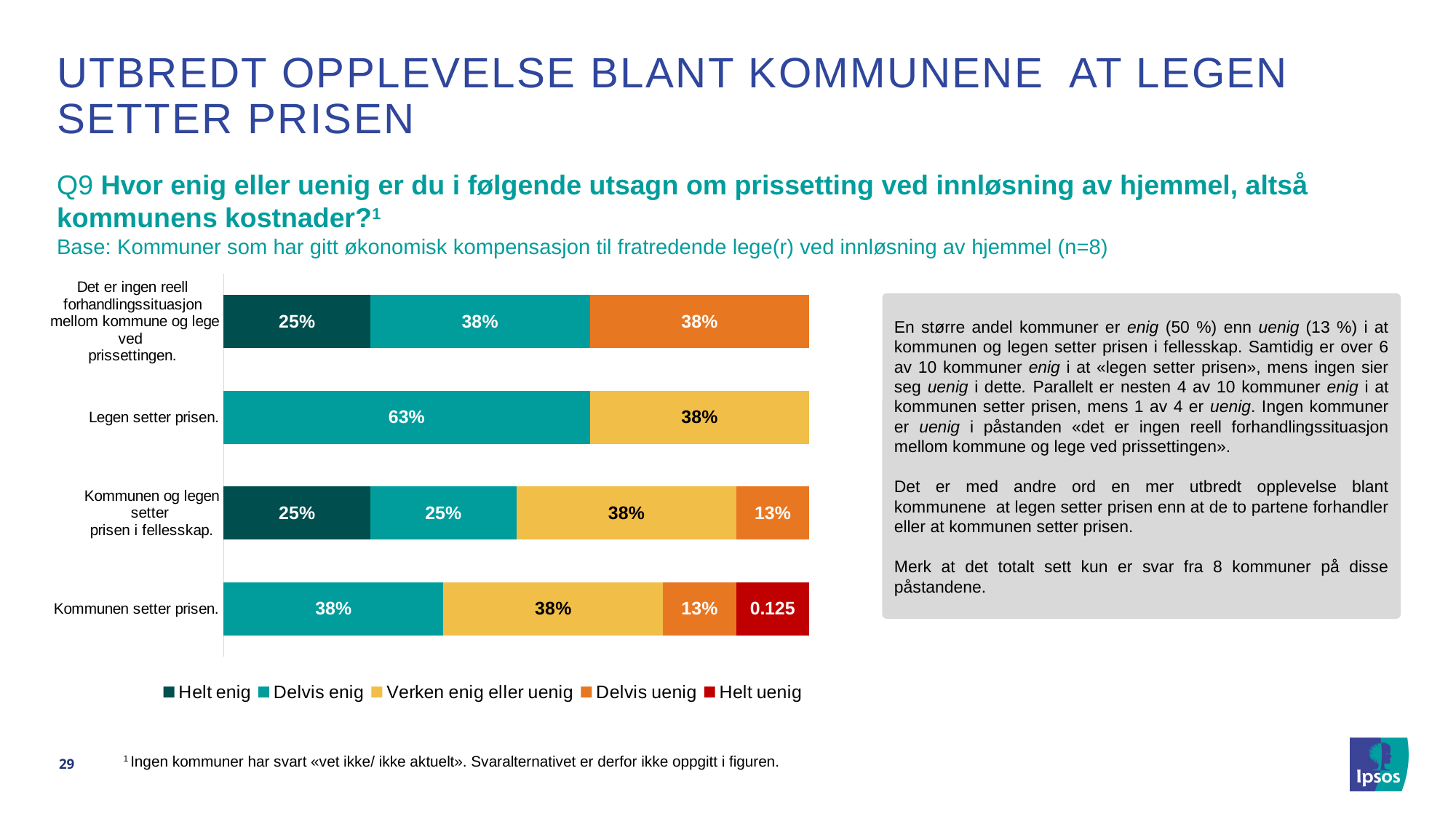
For 'Legen setter prisen.', what is the difference between the 'Delvis enig' and 'Verken enig eller uenig' values? 25 percentage points How many statements (categories) are shown in the chart? 4 What is the 'Delvis uenig' value for 'Kommunen og legen setter prisen i fellesskap.'? 13% Which legend entry is shown in dark red? Helt uenig What is the 'Verken enig eller uenig' value for 'Kommunen setter prisen.'? 38% What is the 'Helt enig' value for 'Det er ingen reell forhandlingssituasjon mellom kommune og lege ved prissettingen.'? 25% How many series does the chart legend list? 5 Which is larger: the 'Delvis enig' value for 'Legen setter prisen.' or the 'Delvis enig' value for 'Kommunen setter prisen.'? Legen setter prisen. What kind of chart is shown on the slide? Stacked bar chart Which statement has the highest 'Delvis enig' share? Legen setter prisen. What is the 'Delvis enig' value for 'Legen setter prisen.'? 63% What is the 'Helt uenig' value shown for 'Kommunen setter prisen.'? 0.125